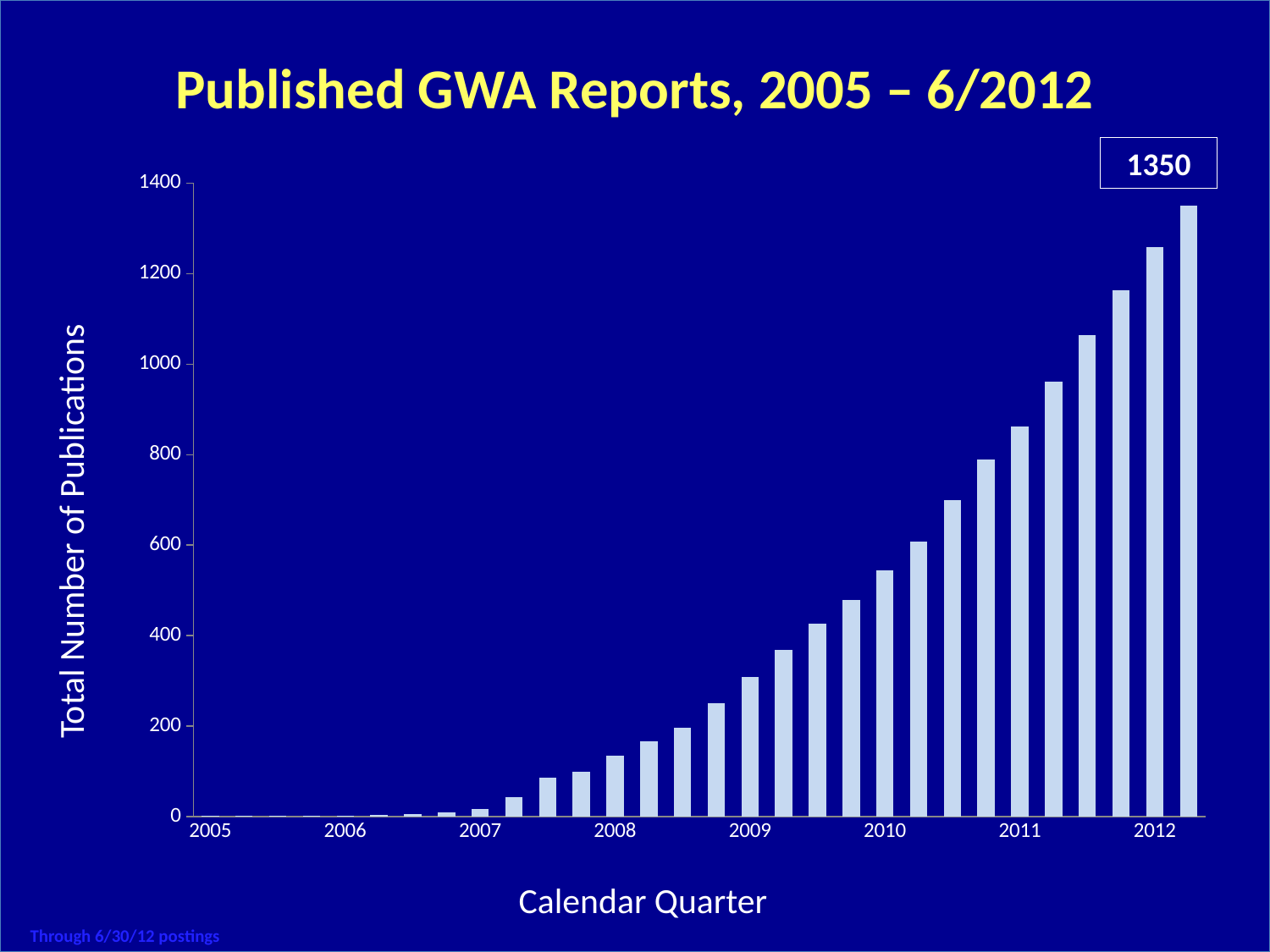
Is the value for the first bar of 2012 greater or less than 1200? greater What is the title of the chart? Published GWA Reports, 2005 – 6/2012 What is the label of the y axis? Total Number of Publications Is the value for the first bar of 2011 greater or less than 800? greater What value is labelled on the tallest bar (the last quarter of the chart)? 1350 How many year labels are shown on the x axis? 8 What kind of chart is shown on the slide? bar chart Which is larger, the first bar of 2010 or the first bar of 2008? the first bar of 2010 Is the value for the first bar of 2009 greater or less than 400? less Do the bar values rise or fall from 2005 to 2012 along the x axis? rise Which year on the x axis contains the highest bar? 2012